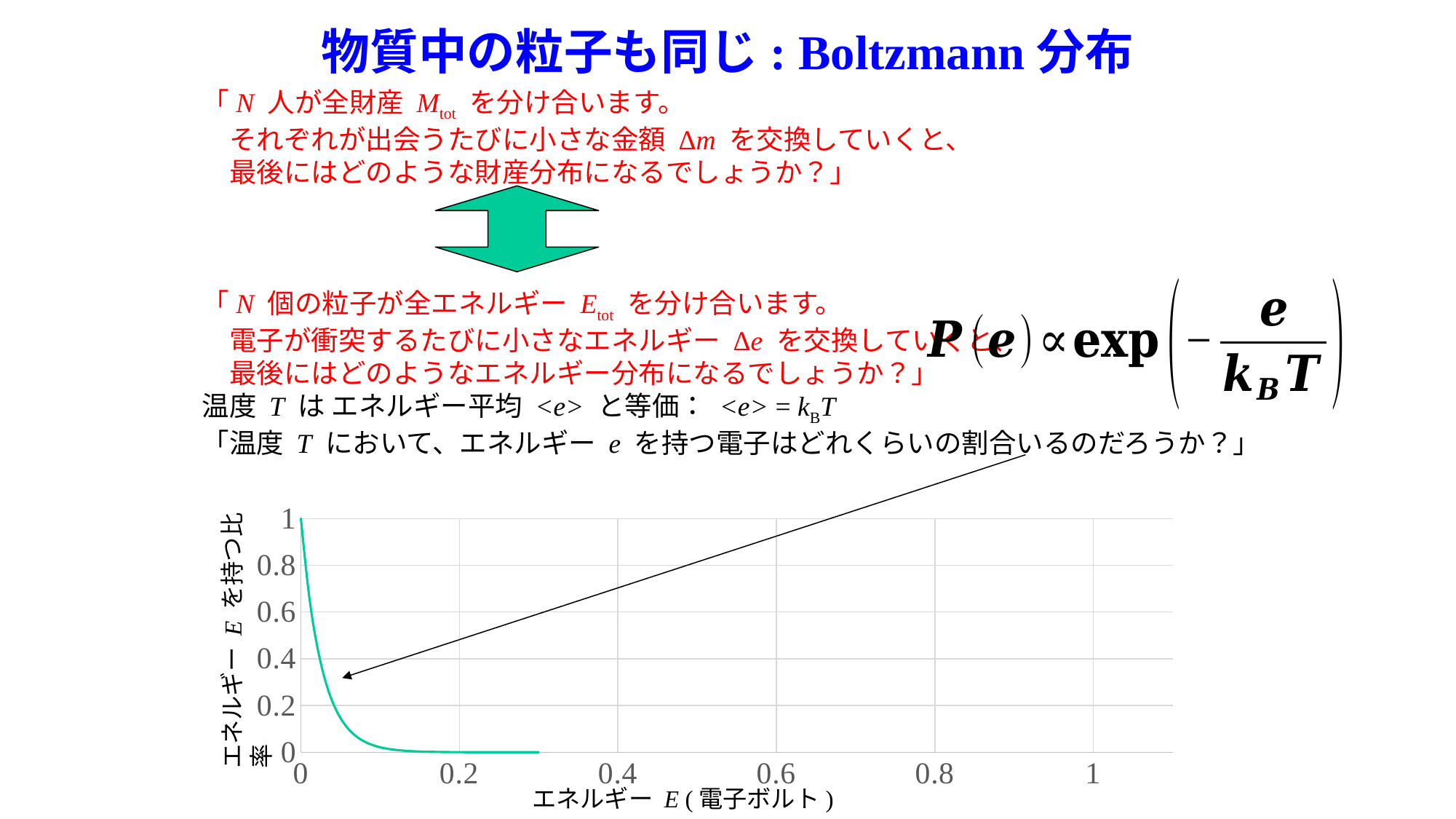
At which energy value does the curve reach its highest point? 0 Is the value of the curve at E = 0.1 greater or less than 0.4? less What is the label of the x axis of the chart? エネルギー E ( 電子ボルト ) What kind of chart is shown at the bottom of the slide? line chart What is the value of the curve at energy E = 0? 1 Which is larger, the curve's value at E = 0 or at E = 0.2? E = 0 What is the largest tick value shown on the x axis? 1 Does the plotted curve rise or fall as energy E increases along the x axis? fall Is the value of the curve at E = 0.2 greater or less than 0.2? less